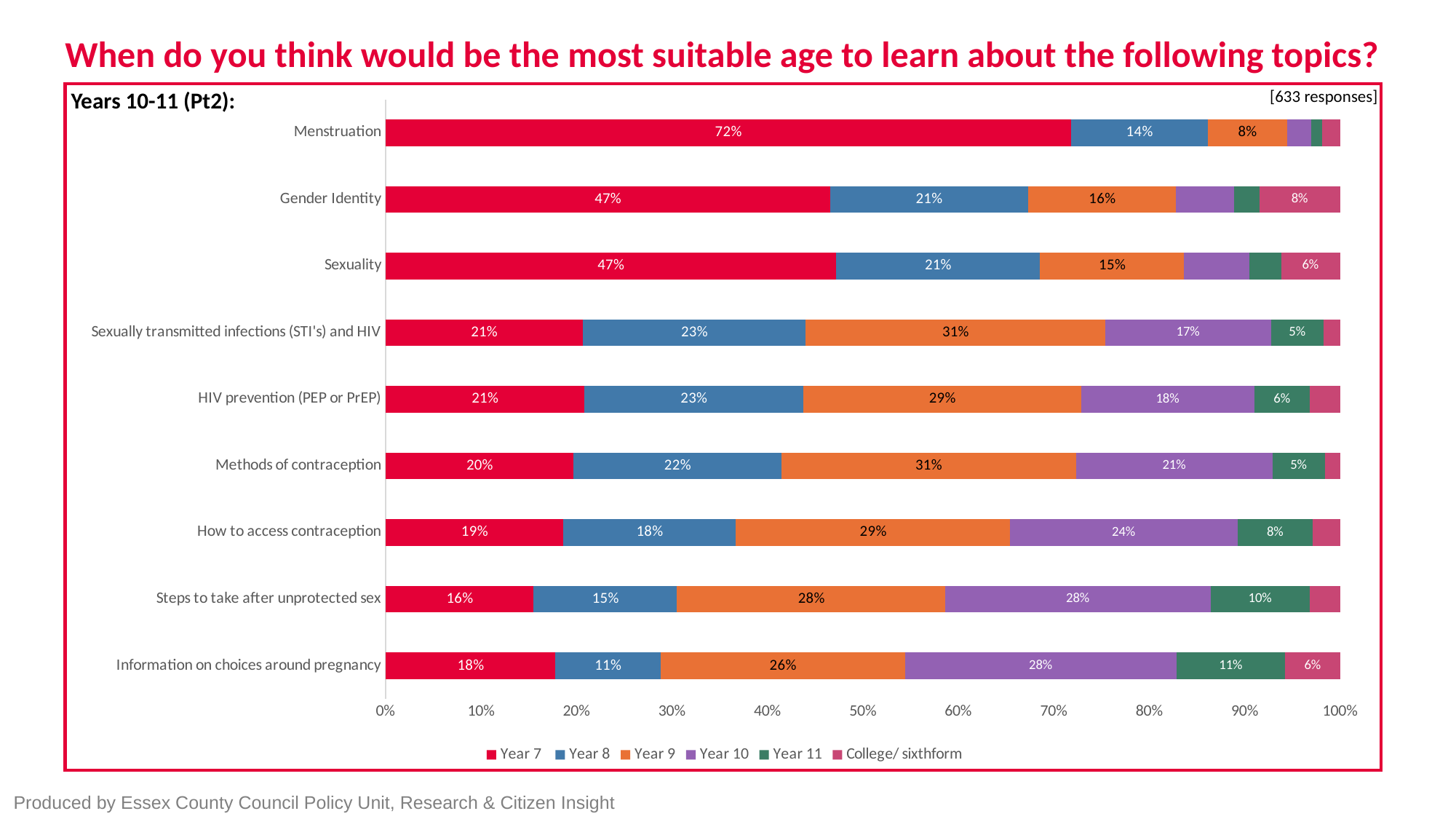
How many responses does the chart note in its top-right corner? 633 responses How many topics are listed on the chart? 9 What kind of chart is shown on the slide? Stacked bar chart What percentage of respondents chose Year 7 as the most suitable age to learn about Menstruation? 72% What is the Year 10 value for Information on choices around pregnancy? 28% Which topic has the highest Year 7 percentage? Menstruation How many series does the legend list? 6 Which is larger: the Year 10 value for How to access contraception or the Year 10 value for Methods of contraception? How to access contraception What is the Year 9 value for Sexually transmitted infections (STI's) and HIV? 31% What is the Year 11 value for Steps to take after unprotected sex? 10% Which topic has the lowest Year 7 percentage? Steps to take after unprotected sex What is the difference between the Year 7 value for Menstruation and the Year 7 value for Gender Identity? 25 percentage points